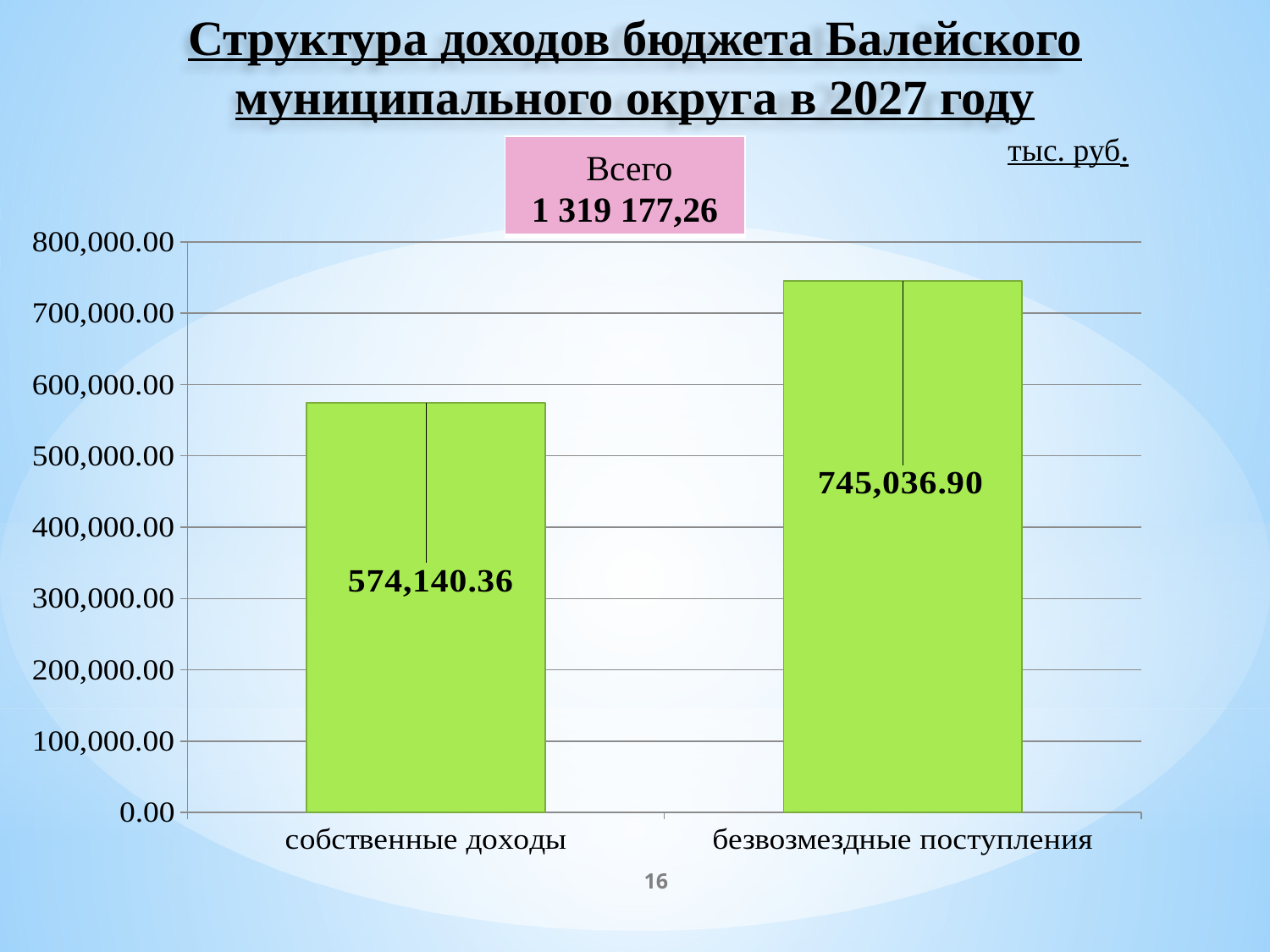
Which is larger, собственные доходы or безвозмездные поступления? безвозмездные поступления Is the value for собственные доходы greater or less than 600,000.00? less How many categories are shown on the chart? 2 What is the value for собственные доходы? 574,140.36 What kind of chart is shown on the slide? bar chart What is the difference between безвозмездные поступления and собственные доходы? 170,896.54 Which category has the highest value? безвозмездные поступления What unit of measurement is indicated on the slide? тыс. руб. What total (Всего) is shown above the chart? 1 319 177,26 What is the value for безвозмездные поступления? 745,036.90 Which category has the lowest value? собственные доходы Is the value for безвозмездные поступления greater or less than 700,000.00? greater